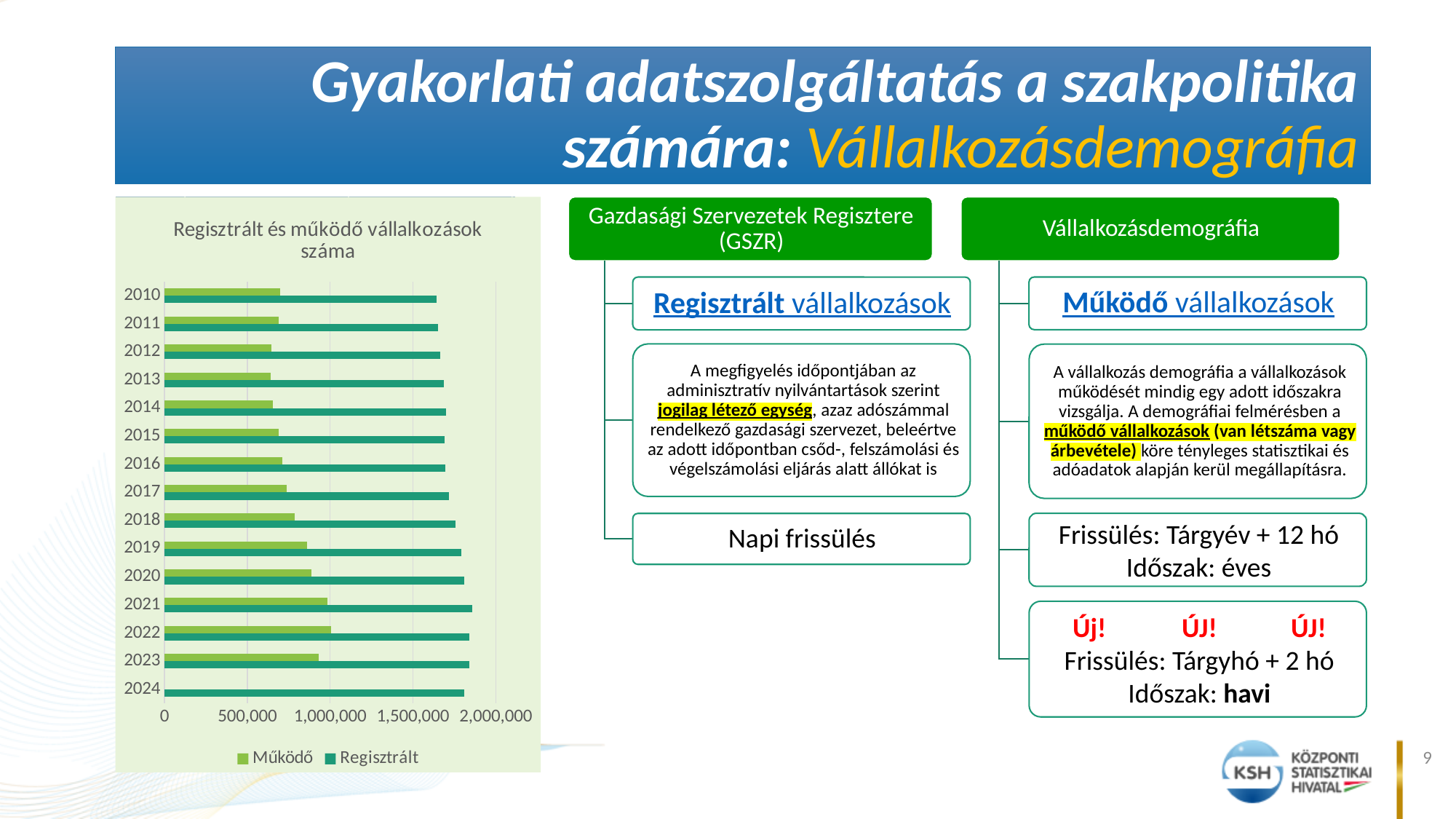
Do the Regisztrált values generally rise or fall from 2010 to 2024? rise Is the Működő value larger in 2010 or in 2022? 2022 Is the Működő value for 2013 greater or less than 1,000,000? less Is the Regisztrált value for 2021 greater or less than 2,000,000? less How many years are shown on the chart's vertical axis? 15 Is the Működő value for 2010 greater or less than 1,000,000? less In 2015, which series has the larger value, Működő or Regisztrált? Regisztrált What is the title of the chart on the slide? Regisztrált és működő vállalkozások száma What kind of chart is shown on the slide? bar chart Which series is shown in the darker green colour in the chart? Regisztrált How many series does the chart's legend list? 2